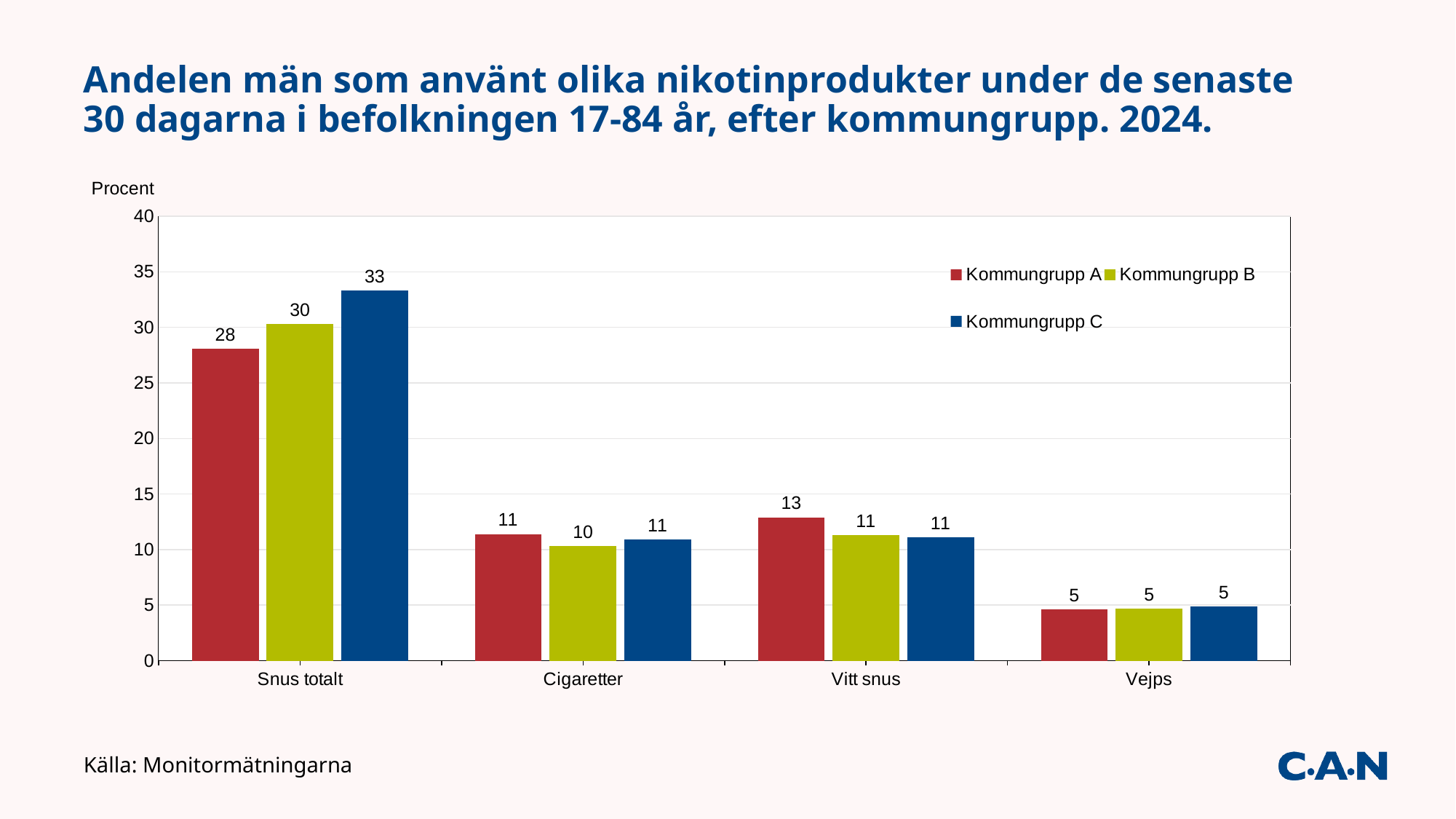
In the Snus totalt category, which is larger: Kommungrupp B or Kommungrupp A? Kommungrupp B What is the difference between Kommungrupp C and Kommungrupp A in the Snus totalt category? 5 How many categories are shown on the x axis? 4 How many series does the legend list? 3 Which category has the lowest value for Kommungrupp C? Vejps What kind of chart is shown on the slide? Bar chart Which category has the highest value for Kommungrupp A? Snus totalt What is the label of the y axis? Procent Is the value for Kommungrupp A in the Snus totalt category greater or less than 25? greater What is the value for Kommungrupp C in the Snus totalt category? 33 What is the value for Kommungrupp B in the Cigaretter category? 10 What is the value for Kommungrupp A in the Vitt snus category? 13